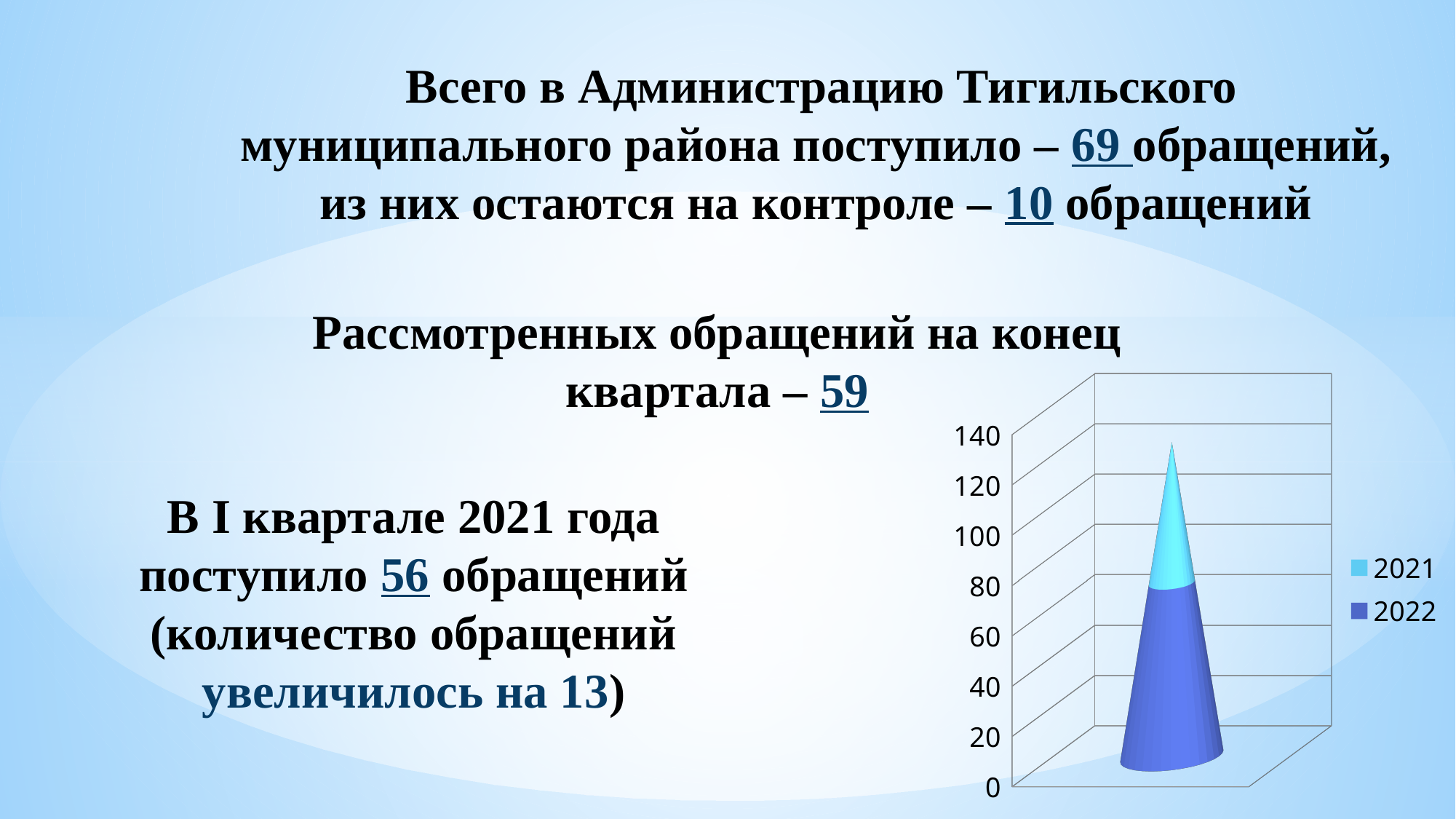
Is the total height of the stacked bar greater or less than 140? less How many series does the chart legend list? 2 Which series is shown in the lighter blue colour in the chart? 2021 How many bars (categories) are plotted in the chart? 1 Which series are listed in the chart legend? 2021 and 2022 What is the highest value shown on the chart's vertical axis? 140 Is the total height of the stacked bar greater or less than 100? greater What kind of chart is shown on the slide? bar chart Is the value of the 2022 segment of the bar greater or less than 40? greater Which series occupies the larger segment of the stacked bar, 2021 or 2022? 2022